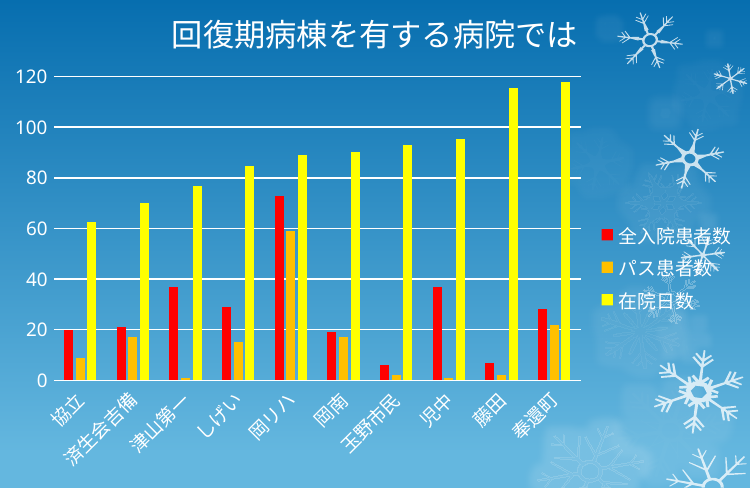
What kind of chart is shown on the slide? bar chart Do the 在院日数 values rise or fall from left to right along the x axis? rise Is the 全入院患者数 value for 岡リハ greater or less than 60? greater What is the title of the chart? 回復期病棟を有する病院では Which hospital has the lowest 在院日数? 協立 Which hospital has the highest 全入院患者数? 岡リハ Which colour represents パス患者数 in the legend? orange Which hospital has the highest 在院日数? 奉還町 How many series does the legend list? 3 Which is larger, the 在院日数 for 児中 or for 協立? 児中 How many hospitals (categories) are shown on the x axis? 10 Is the 在院日数 value for 奉還町 greater or less than 100? greater